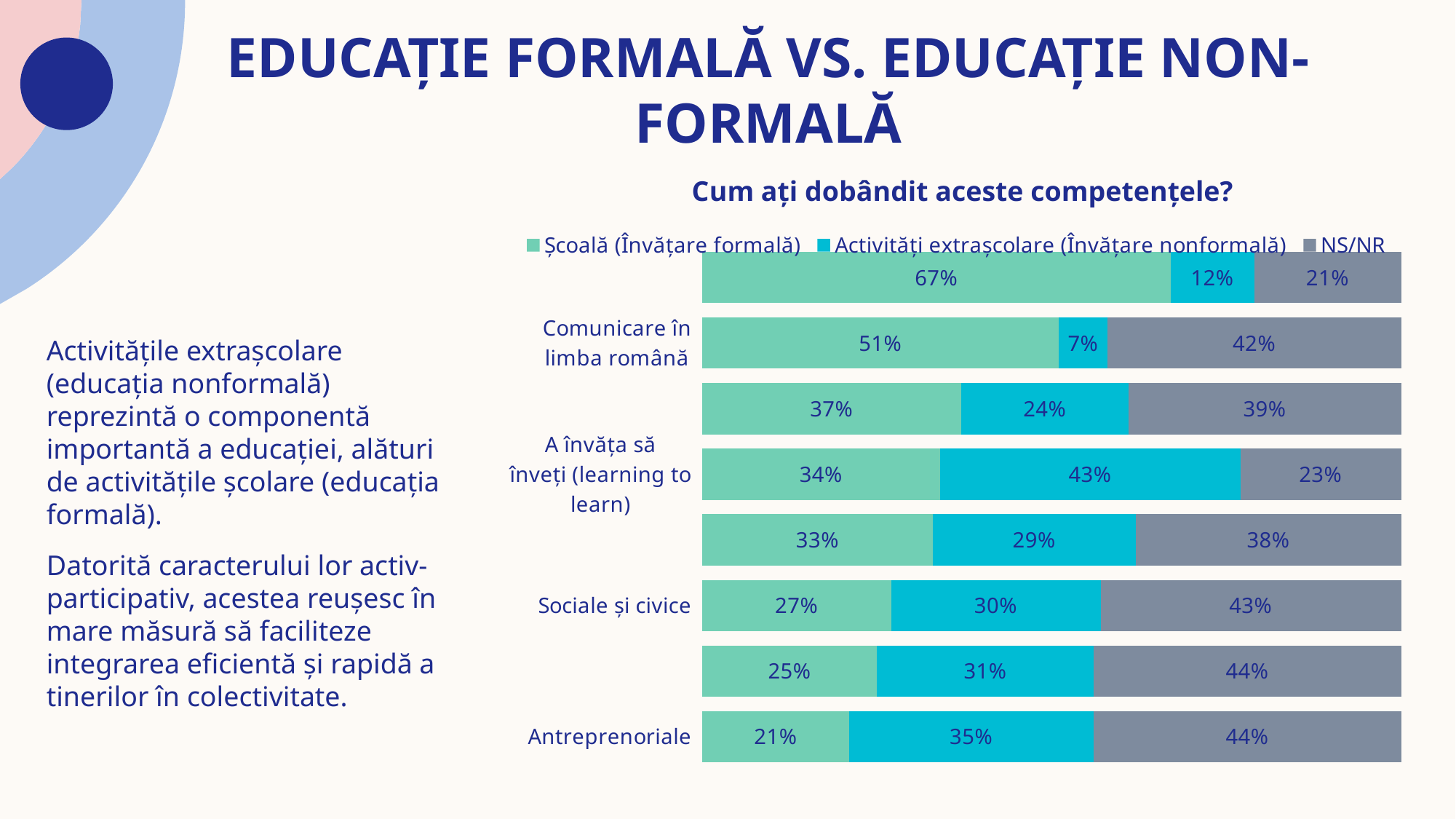
What percentage of respondents acquired 'Comunicare în limba română' competences through Școală (Învățare formală)? 51% What is the NS/NR value for 'Antreprenoriale'? 44% What is the total of the stacked bar for 'Sociale și civice'? 100% What kind of chart is shown on the slide? Stacked bar chart What is the difference between the Activități extrașcolare (Învățare nonformală) values for 'A învăța să înveți (learning to learn)' and 'Sociale și civice'? 13% What is the title of the chart? Cum ați dobândit aceste competențele? What is the difference between the Școală (Învățare formală) value and the NS/NR value for 'Comunicare în limba română'? 9% What is the Școală (Învățare formală) value for 'Sociale și civice'? 27% What is the value for Activități extrașcolare (Învățare nonformală) in the 'A învăța să înveți (learning to learn)' category? 43% How many series does the legend list? 3 For 'Antreprenoriale', which is larger: the Școală (Învățare formală) value or the Activități extrașcolare (Învățare nonformală) value? Activități extrașcolare (Învățare nonformală) What is the Activități extrașcolare (Învățare nonformală) value for 'Comunicare în limba română'? 7%